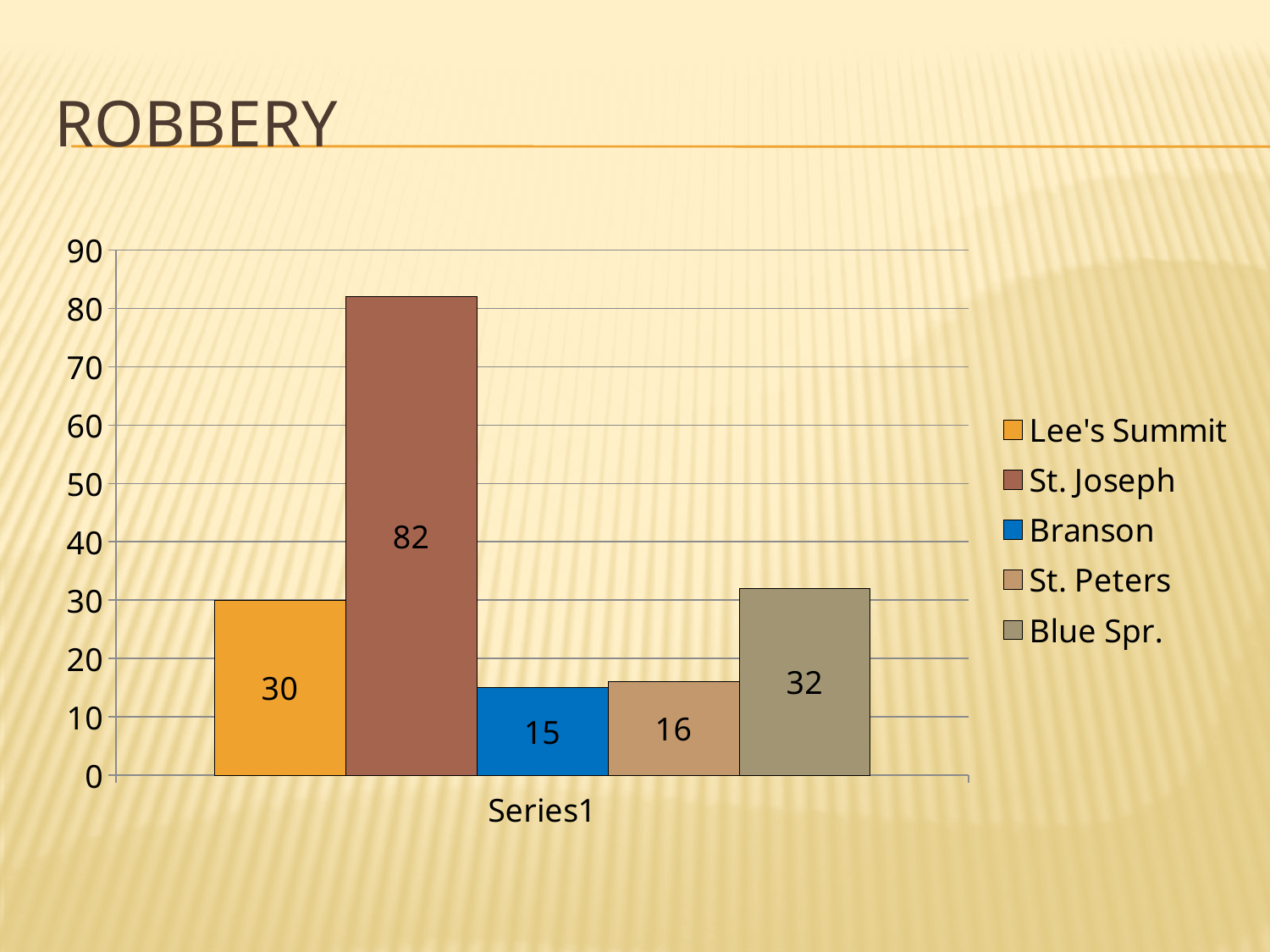
What is the value for Branson? 15 How many entries does the legend list? 5 Which city has the lowest value? Branson Which city has the highest value? St. Joseph Is the value for St. Joseph greater or less than 70? greater What is the title of the slide? ROBBERY What kind of chart is shown on the slide? bar chart What is the value for Lee's Summit? 30 Which is larger, the value for Lee's Summit or the value for Blue Spr.? Blue Spr. What is the difference between the values for St. Peters and Branson? 1 What is the value for St. Joseph? 82 What is the difference between the values for St. Joseph and Blue Spr.? 50